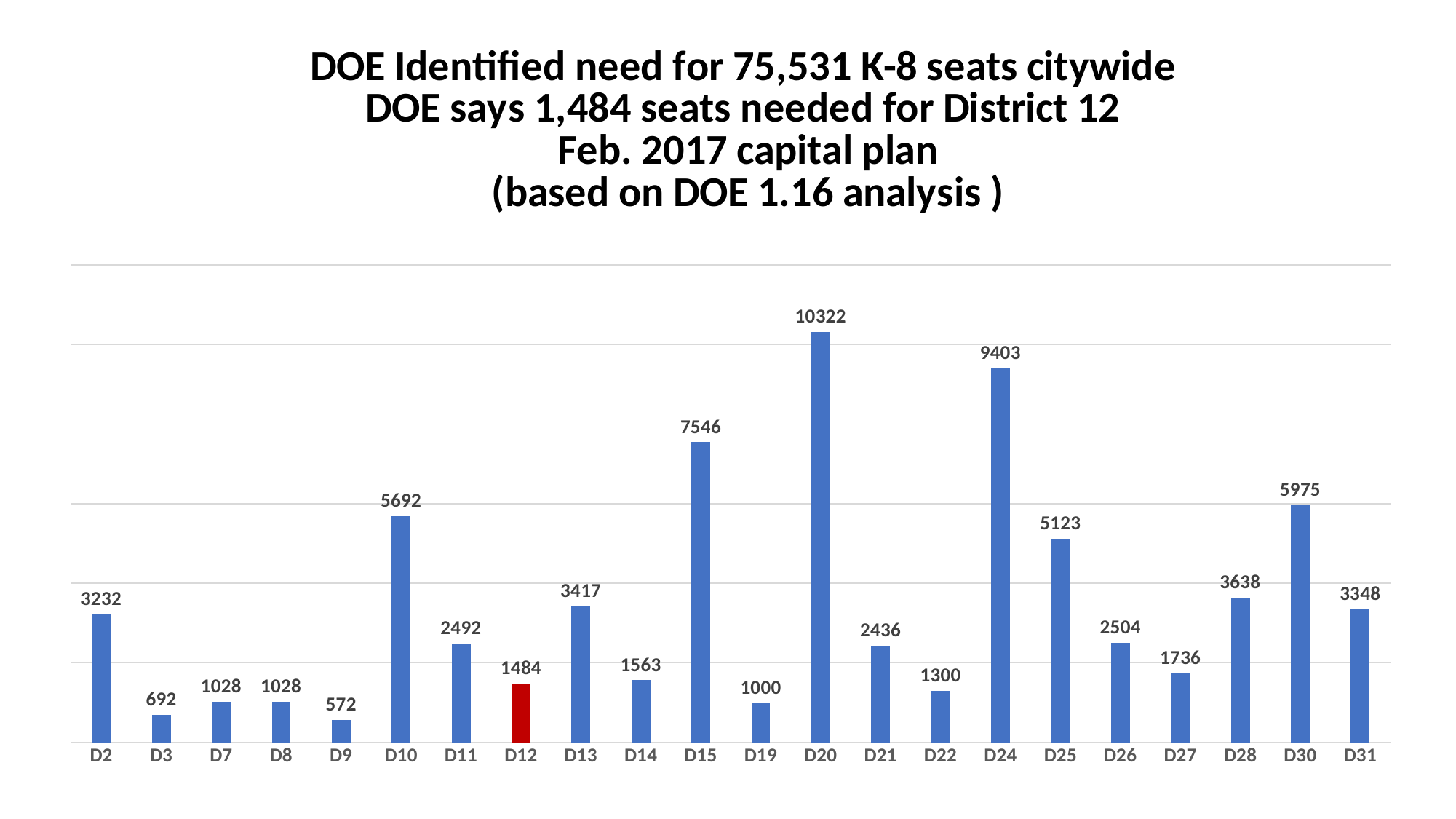
Which is larger, the value for D2 or the value for D13? D13 What is the value for D9? 572 Which bar is coloured red instead of blue? D12 What is the value for D20? 10322 What is the difference between the values for D20 and D24? 919 Which is larger, the value for D15 or the value for D30? D15 What kind of chart is shown on the slide? bar chart How many districts are shown on the x axis? 22 Which district has the lowest value? D9 Which district has the highest value? D20 What is the value for D12? 1484 What is the difference between the values for D10 and D11? 3200